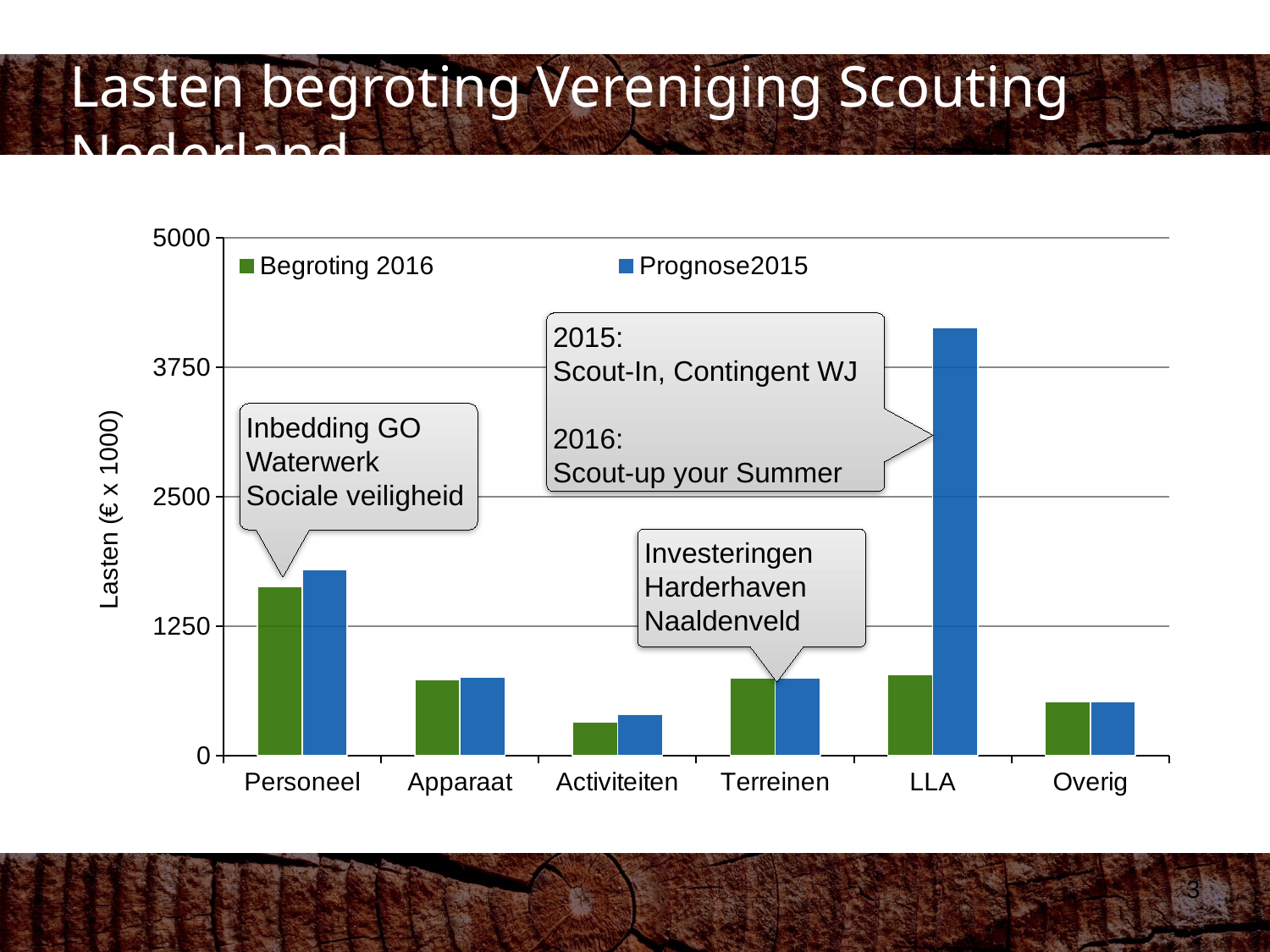
Which category has the highest value for the Prognose2015 series? LLA Is the Prognose2015 value for Activiteiten greater or less than 1250? less Which category has the lowest value for the Begroting 2016 series? Activiteiten For LLA, which series has the larger value: Begroting 2016 or Prognose2015? Prognose2015 What is the label of the vertical axis of the chart? Lasten (€ x 1000) What kind of chart is shown on the slide? bar chart Which series is shown in green in the chart? Begroting 2016 Is the Prognose2015 value for LLA greater or less than 3750? greater How many categories are shown on the x axis of the chart? 6 Is the Begroting 2016 value for Personeel greater or less than 1250? greater For the Begroting 2016 series, which is larger: Personeel or Apparaat? Personeel How many series does the chart legend list? 2